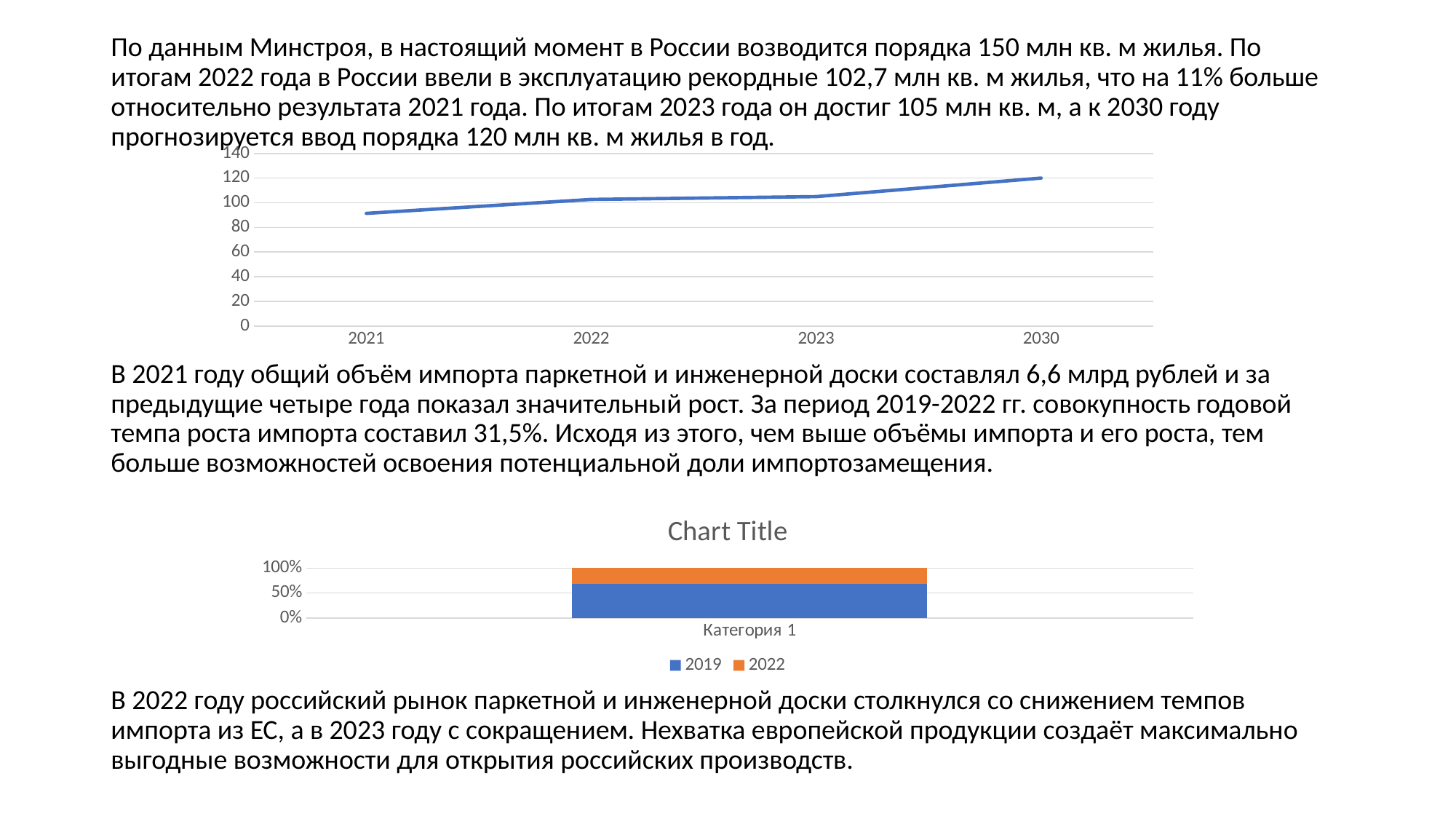
In the bottom chart titled "Chart Title", how many series does the legend list? 2 What kind of chart is the top chart on the slide? line chart In the top line chart, is the value for 2023 greater or less than 80? greater In the top line chart, is the value for 2021 greater or less than 100? less In the top line chart, is the value for 2030 greater or less than 100? greater What kind of chart is the bottom chart titled "Chart Title"? stacked bar chart In the bottom chart titled "Chart Title", what is the label of the only category on the x axis? Категория 1 In the top line chart, which year has the highest value? 2030 In the bottom chart titled "Chart Title", which series has the larger share of the bar for Категория 1, 2019 or 2022? 2019 In the top line chart, how many points are plotted along the x axis? 4 In the top line chart, which year has the lowest value? 2021 In the top line chart, do the values rise or fall from 2021 to 2030? rise